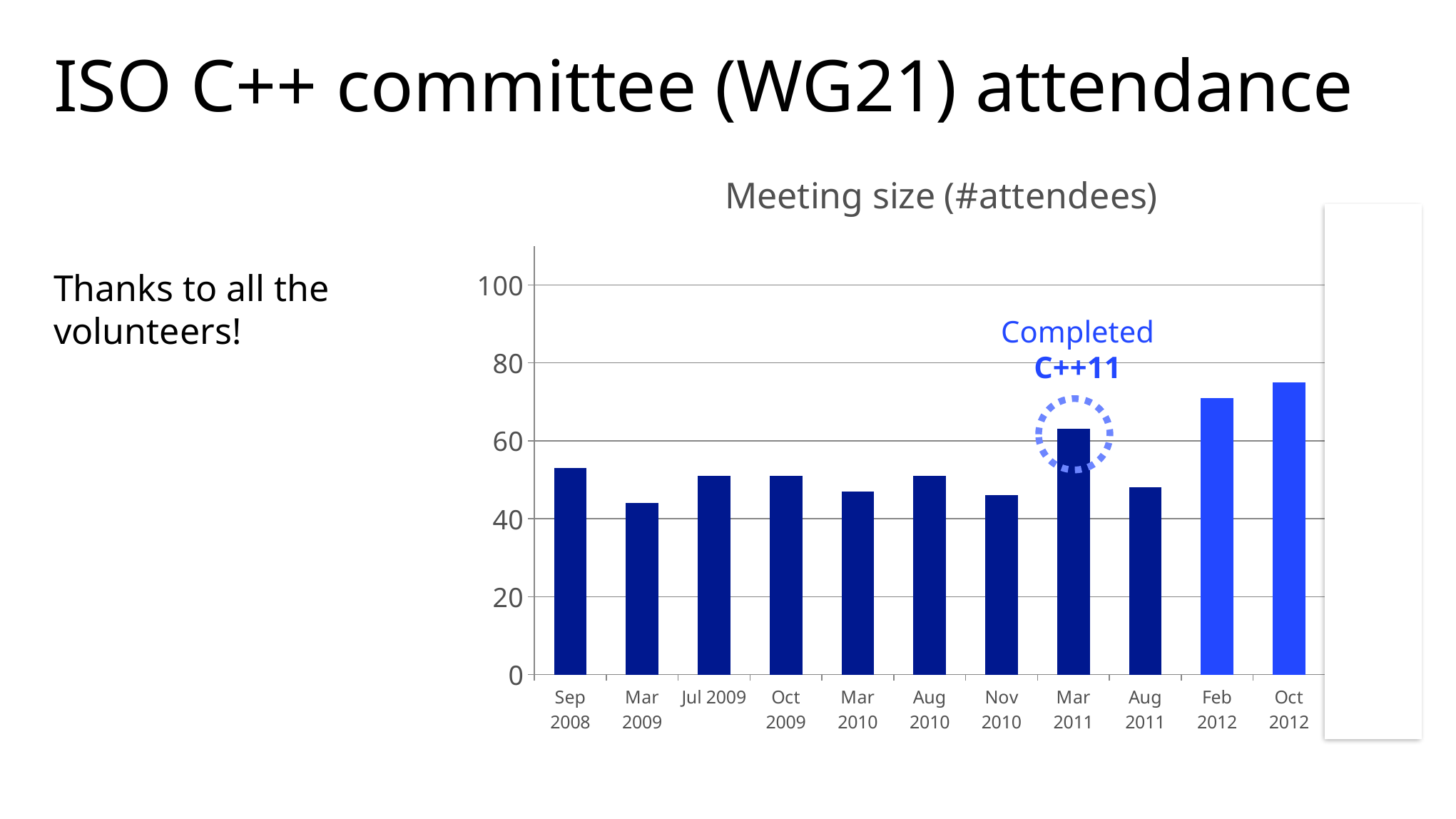
Which meeting is annotated with 'Completed C++11'? Mar 2011 Is the value for Nov 2010 greater or less than 60? less Is the value for Feb 2012 greater or less than 60? greater Is the value for Mar 2011 greater or less than 60? greater What kind of chart is shown on the slide? bar chart Which is larger, the value for Sep 2008 or the value for Feb 2012? Feb 2012 Which is larger, the value for Mar 2011 or the value for Aug 2011? Mar 2011 Which meeting has the highest attendance in the chart? Oct 2012 How many meetings (bars) are plotted in the chart? 11 What is the title of the chart? Meeting size (#attendees)